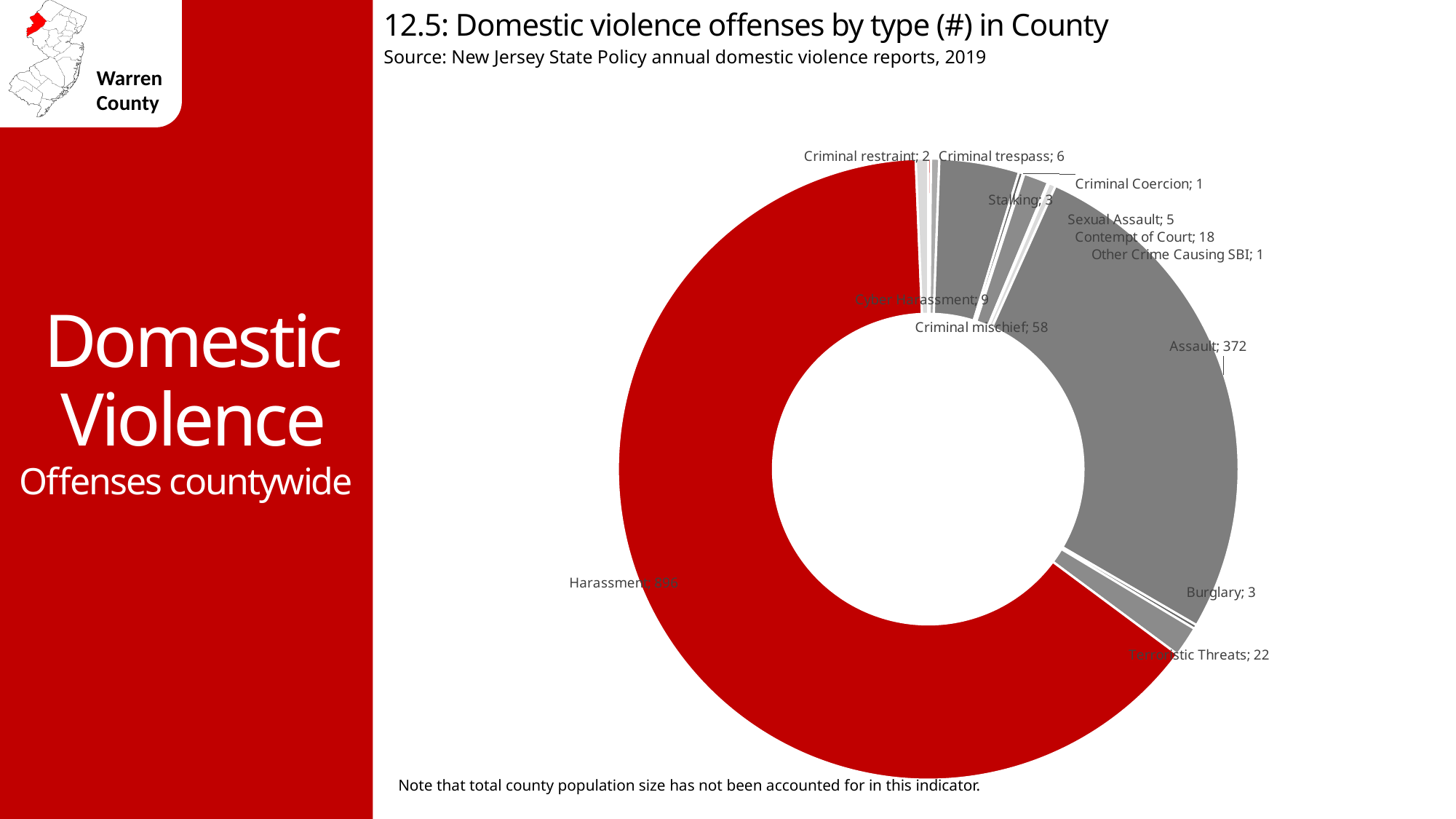
What kind of chart is shown on the slide? Pie (donut) chart What is the value for Assault? 372 What is the difference between the values for Assault and Criminal mischief? 314 What is the value for Criminal trespass? 6 What is the value for Terroristic Threats? 22 What is the title of the chart? 12.5: Domestic violence offenses by type (#) in County What is the value for Cyber Harassment? 9 Which is larger, the value for Contempt of Court or the value for Terroristic Threats? Terroristic Threats Which offense type has the largest slice of the chart? Harassment What is the value for Criminal mischief? 58 How many offense types are shown in the chart? 13 What is the value for Contempt of Court? 18